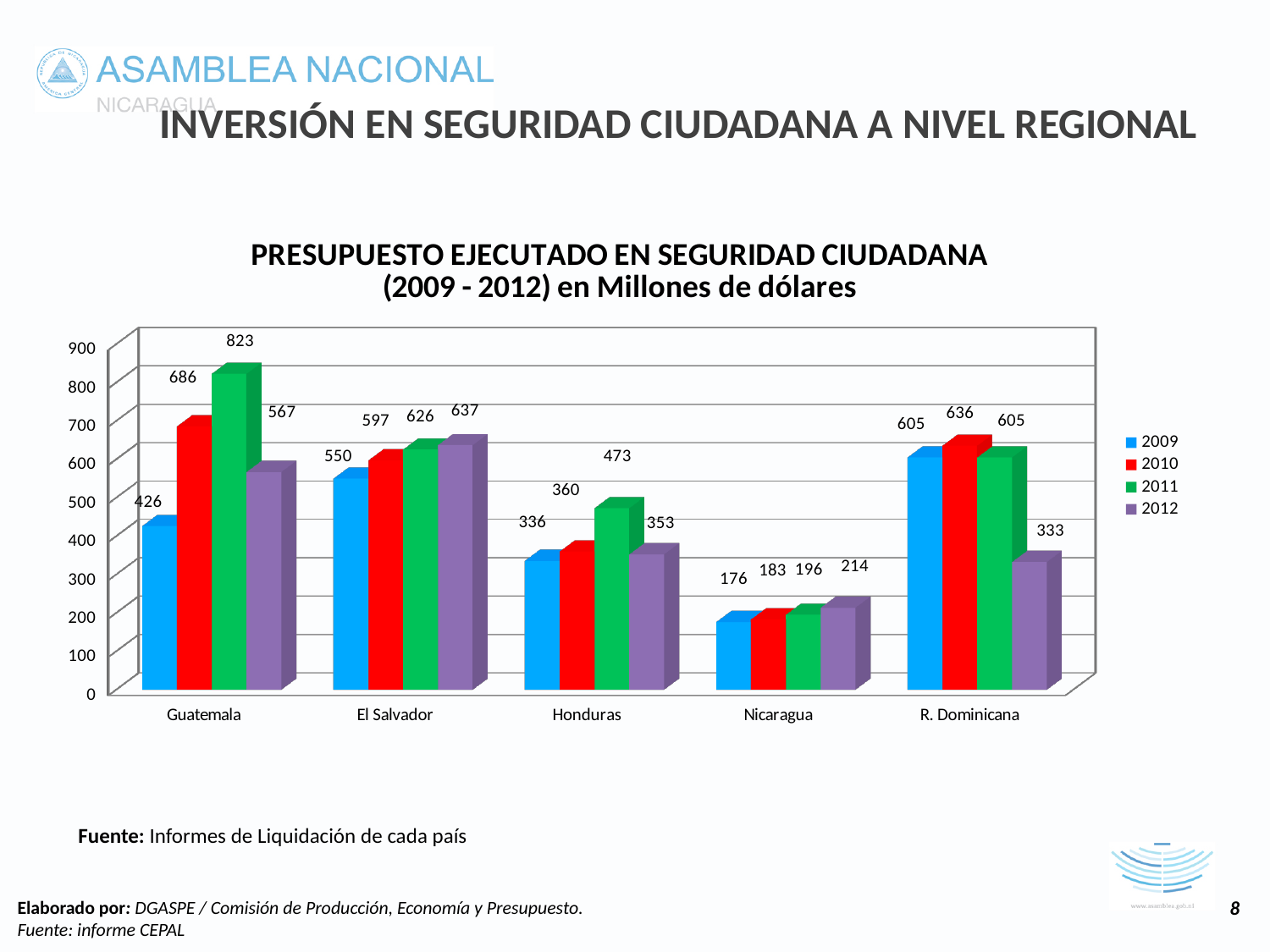
Which is larger, El Salvador's 2012 value or R. Dominicana's 2010 value? El Salvador's 2012 value Which colour represents the year 2010 in the legend? Red Which country had the lowest executed budget in 2012? Nicaragua What kind of chart is shown on the slide? Bar chart How many series does the legend list? 4 What was the executed budget for Nicaragua in 2009? 176 What is the difference between Honduras's 2011 value and Nicaragua's 2011 value? 277 What was the executed budget for Guatemala in 2011? 823 What is the difference between Guatemala's 2011 value and its 2012 value? 256 Which country had the highest executed budget in 2011? Guatemala What was the executed budget for R. Dominicana in 2012? 333 How many countries are shown on the x axis? 5